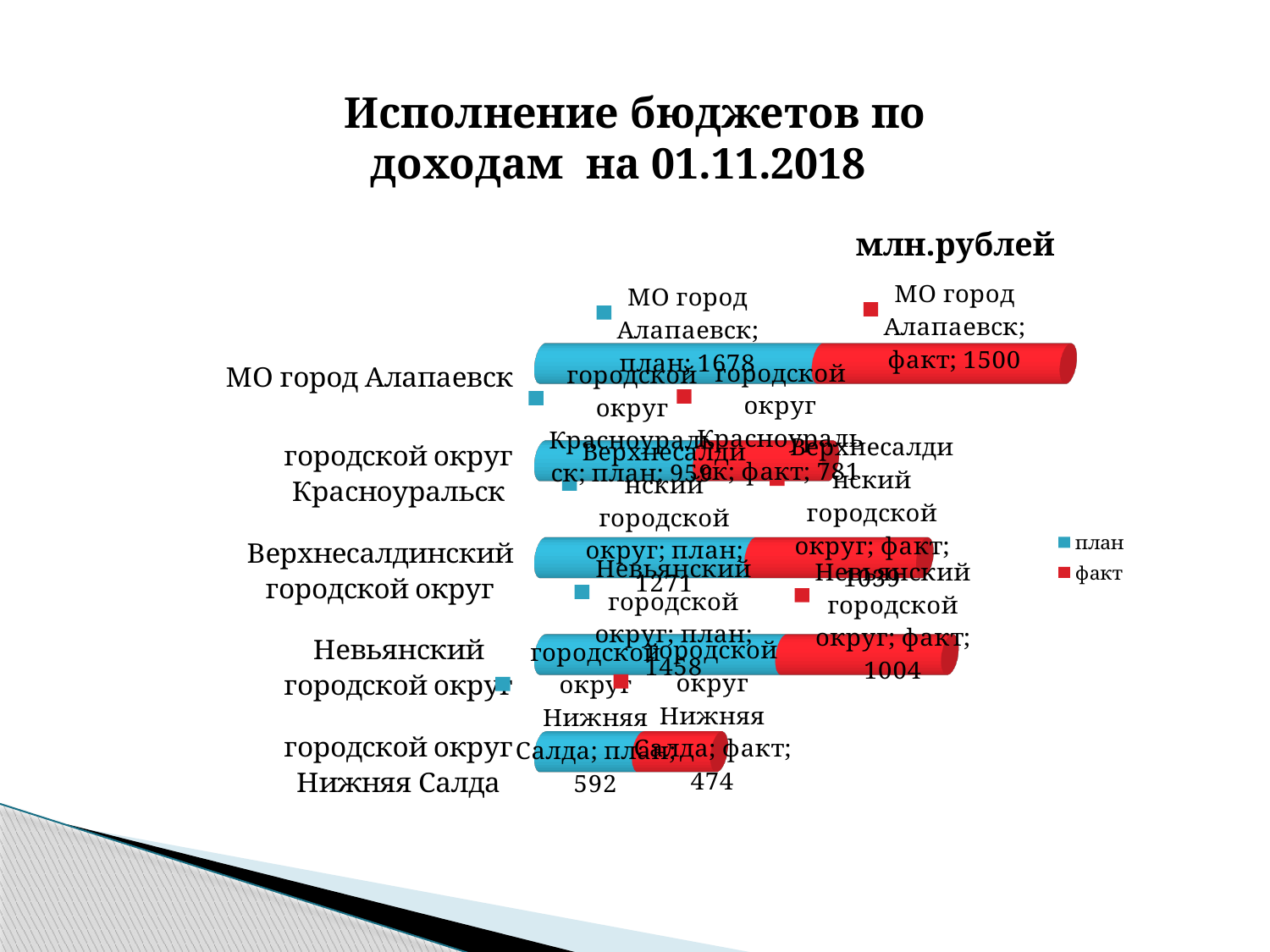
What is the план value for МО город Алапаевск? 1678 What is the факт value for МО город Алапаевск? 1500 What is the план value for городской округ Нижняя Салда? 592 Which category has the highest план value? МО город Алапаевск What kind of chart is shown on the slide? bar chart What is the difference between план and факт for МО город Алапаевск? 178 What is the план value for Верхнесалдинский городской округ? 1271 How many series does the legend list? 2 Which category has the lowest факт value? городской округ Нижняя Салда How many categories (municipalities) are shown on the chart? 5 What is the факт value for Невьянский городской округ? 1004 What is the факт value for городской округ Красноуральск? 781